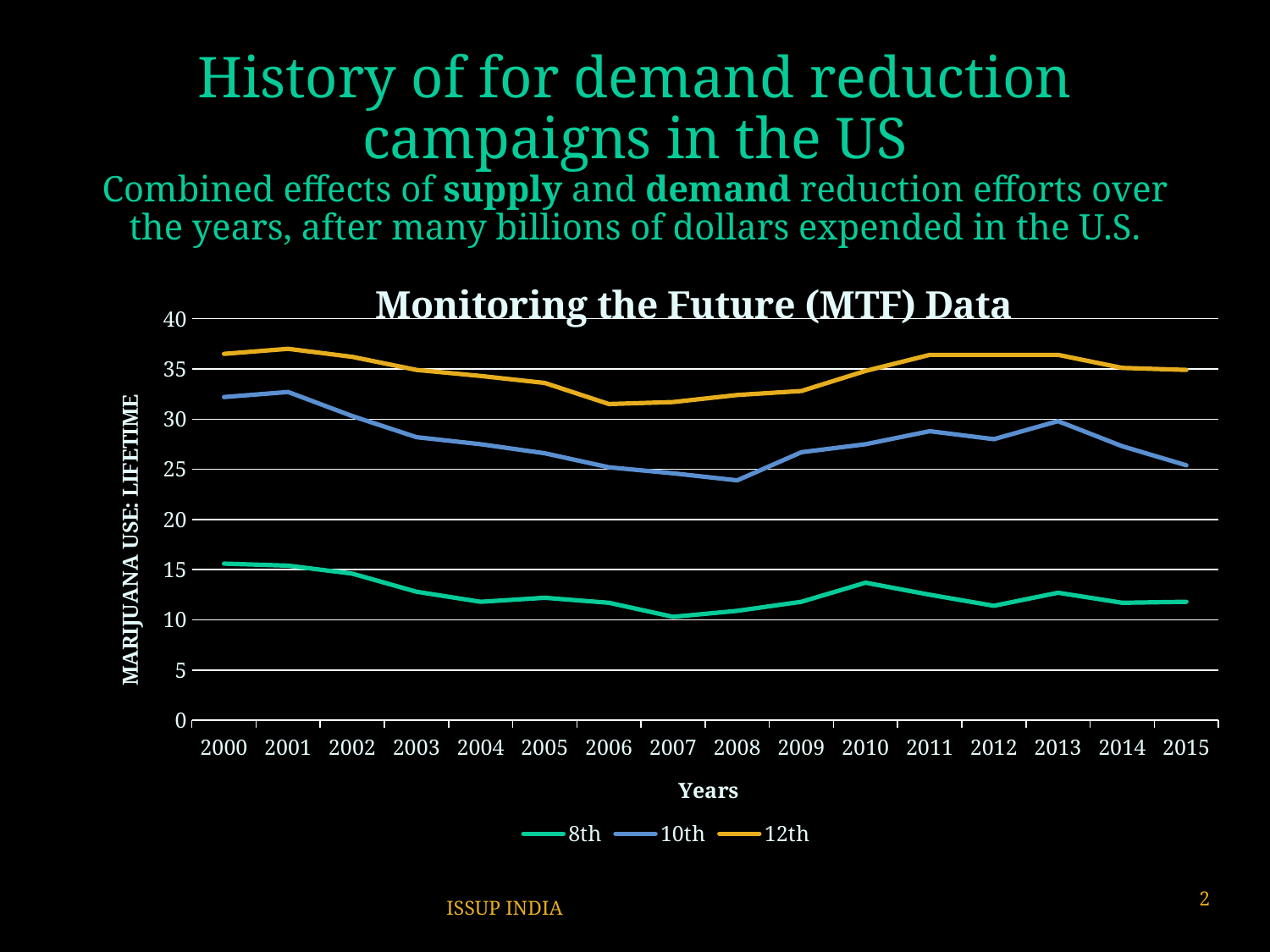
What is the title of the chart? Monitoring the Future (MTF) Data How many years are plotted along the x axis? 16 Which series has the highest values across all years? 12th Is the value for 10th in 2008 greater or less than 25? less Which series has the lowest values across all years? 8th Does the 8th series rise or fall from 2000 to 2007? fall How many series does the legend list? 3 What is the label on the vertical axis? MARIJUANA USE: LIFETIME Which is larger in 2005, the value for 12th or the value for 8th? 12th Is the value for 8th in 2010 greater or less than 15? less Is the value for 12th in 2000 greater or less than 35? greater What type of chart is shown on the slide? line chart